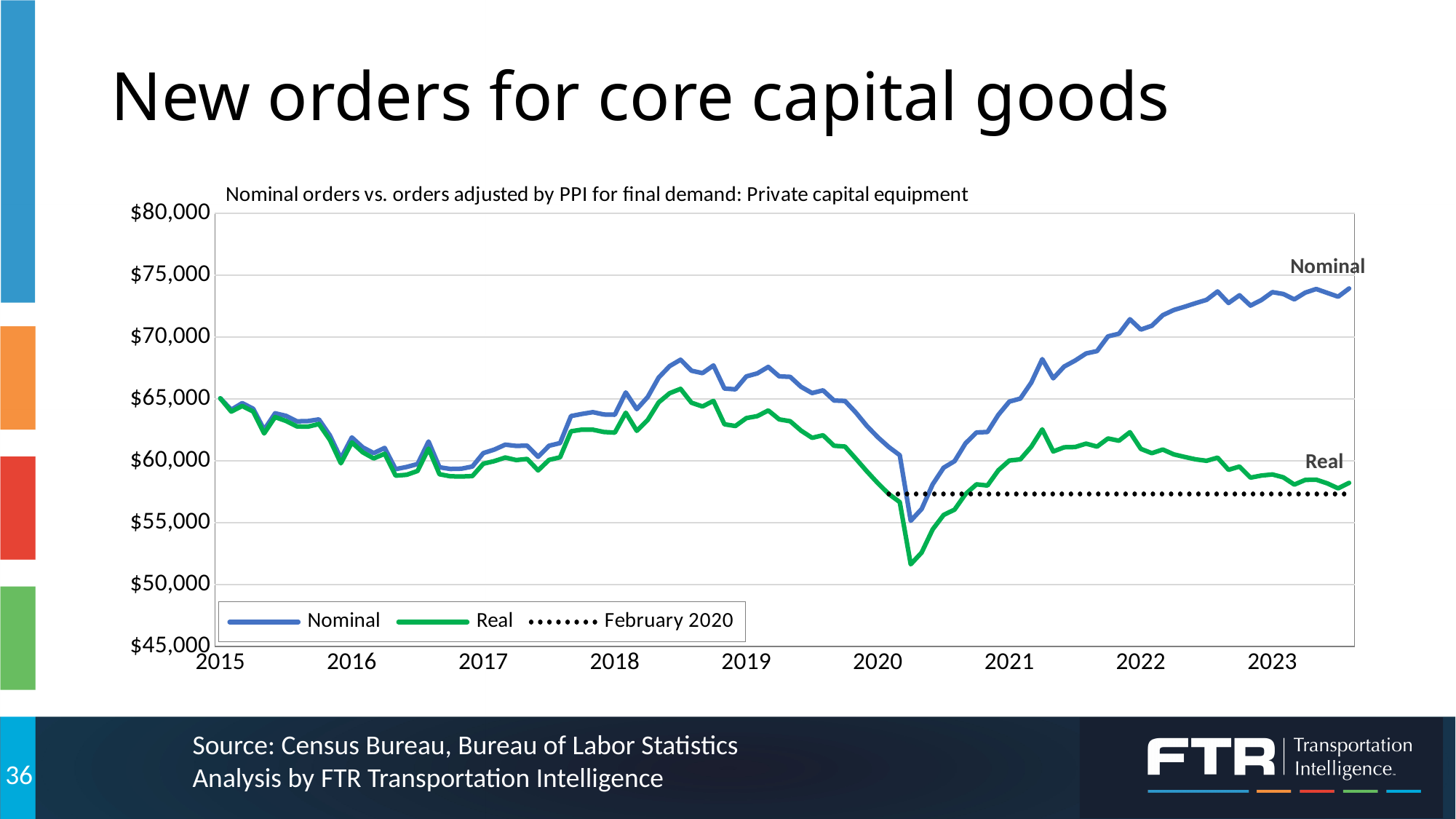
Is the peak of the Nominal series in 2018 greater or less than $65,000? greater Is the value of the Real series at the end of 2023 greater or less than $60,000? less Is the value of the Nominal series at the end of 2023 greater or less than $70,000? greater What is the subtitle printed above the chart? Nominal orders vs. orders adjusted by PPI for final demand: Private capital equipment Which series is plotted with the dotted black line? February 2020 What kind of chart is shown on the slide? Line chart Does the Nominal series rise or fall from its 2020 low to the end of 2023? Rise Does the Real series rise or fall from its 2021 peak to the end of 2023? Fall At the end of 2023, which series is higher, Nominal or Real? Nominal How many entries does the chart legend list? 3